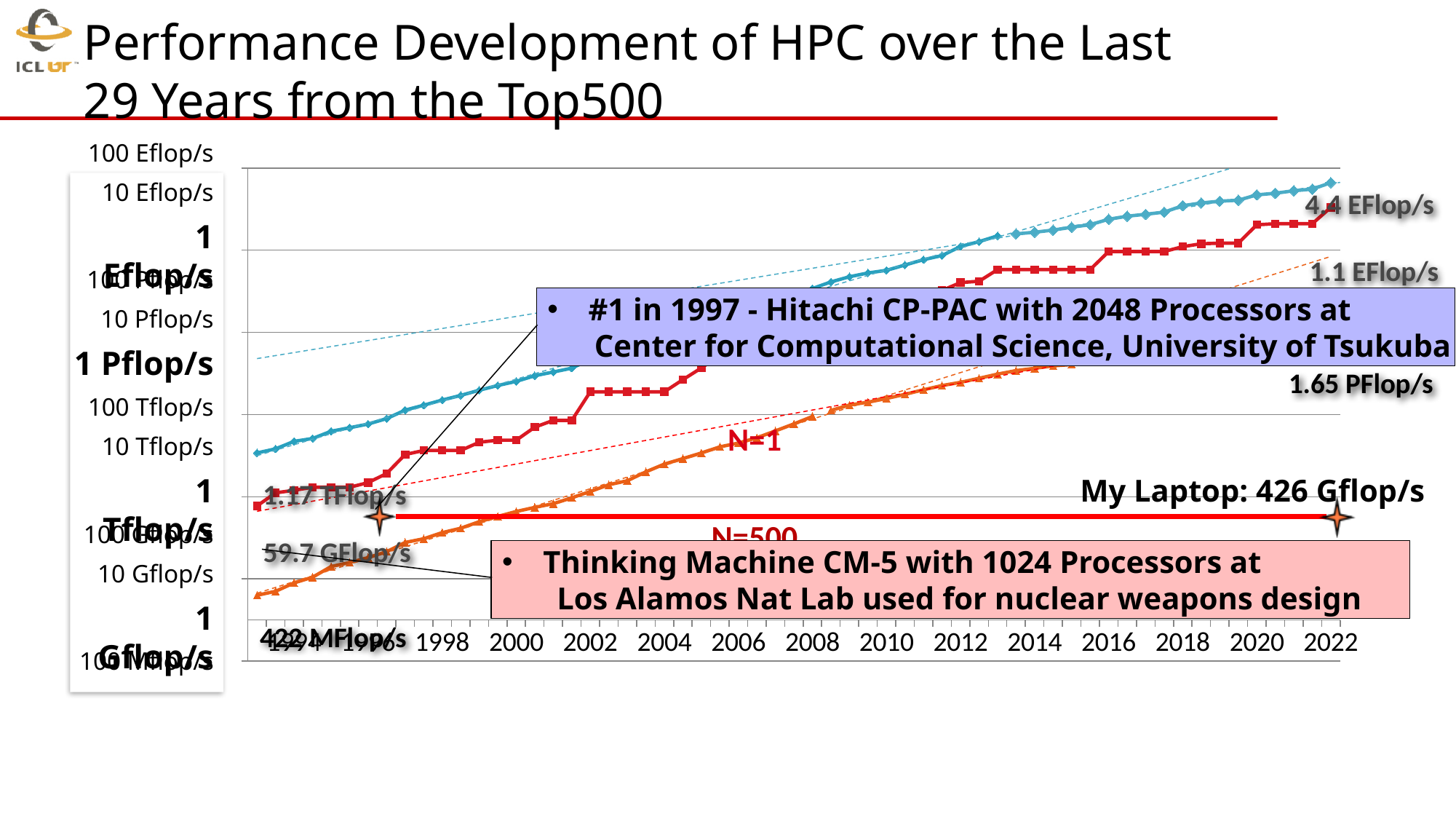
What is the last year labeled on the x axis? 2022 What value is labeled at the start of the N=1 line in 1993? 59.7 GFlop/s In 2022, which is larger: the N=1 value or the N=500 value? N=1 What value is labeled at the 2022 end of the N=500 line? 1.65 PFlop/s Does the N=1 line rise or fall from 1993 to 2022? rise What kind of chart is shown on the slide? line chart What value is labeled at the start of the N=500 line in 1993? 422 MFlop/s What value is labeled at the 2022 end of the top (blue) line? 4.4 EFlop/s How many data series (lines with markers) are plotted on the chart? 3 What value is labeled at the 2022 end of the N=1 line? 1.1 EFlop/s What performance value is given for 'My Laptop' on the chart? 426 Gflop/s